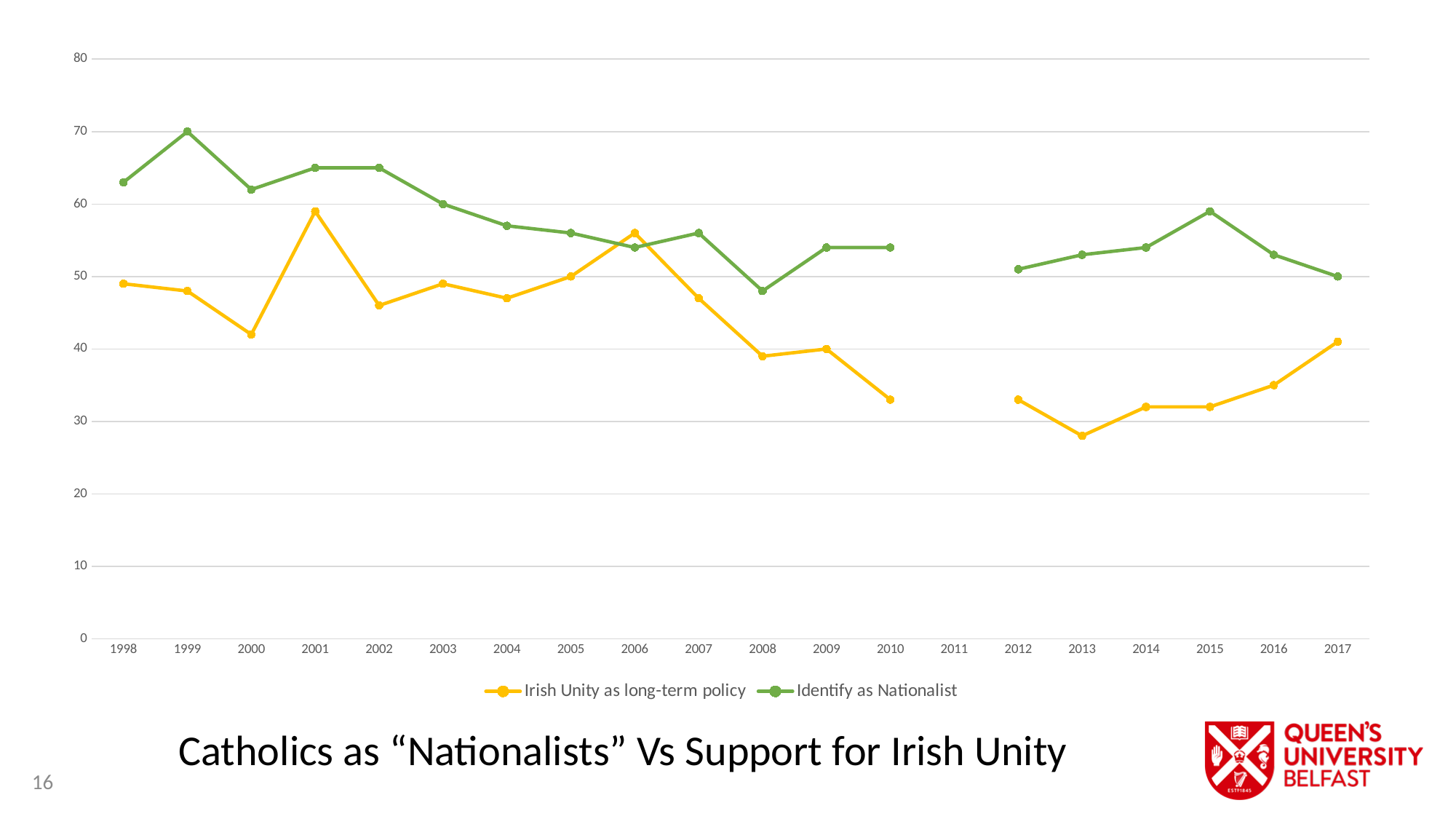
Is the value for 'Irish Unity as long-term policy' in 2013 greater or less than 30? less Does the 'Irish Unity as long-term policy' series rise or fall from 2013 to 2017? rise In which year does the 'Irish Unity as long-term policy' series reach its lowest value? 2013 What is the value for 'Identify as Nationalist' in 1999? 70 In 2010, which series has the larger value, 'Irish Unity as long-term policy' or 'Identify as Nationalist'? Identify as Nationalist How many series does the legend list? 2 In which year does the 'Identify as Nationalist' series reach its highest value? 1999 What kind of chart is shown on the slide? line chart Which colour is used for the 'Identify as Nationalist' series? green Is the value for 'Identify as Nationalist' in 2008 greater or less than 50? less In which year does the 'Irish Unity as long-term policy' series reach its highest value? 2001 What is the title of the chart? Catholics as "Nationalists" Vs Support for Irish Unity